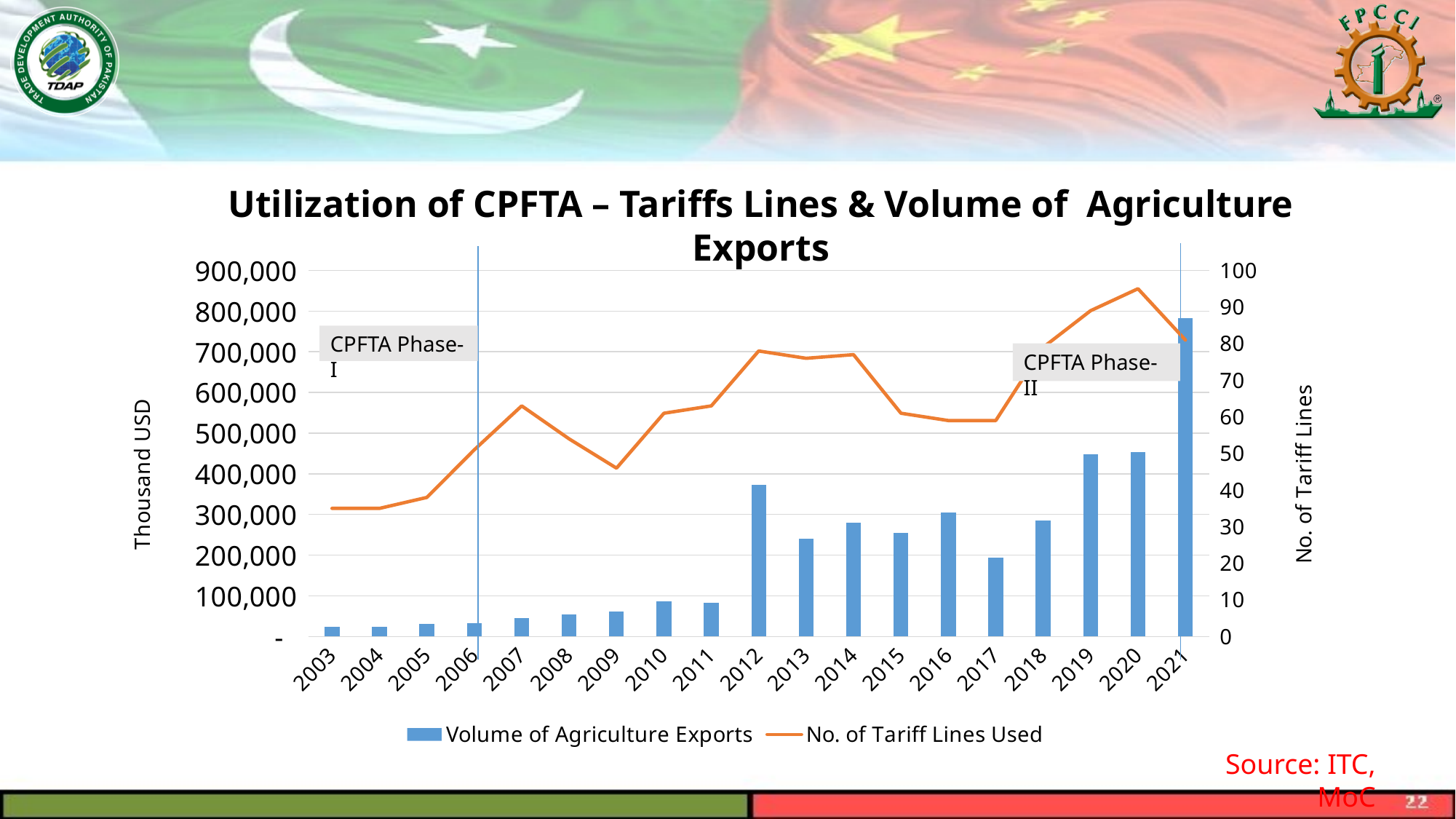
Which year has the highest Volume of Agriculture Exports? 2021 In which year does the No. of Tariff Lines Used line reach its peak? 2020 Is the Volume of Agriculture Exports for 2021 greater or less than 500,000? greater Is the Volume of Agriculture Exports for 2003 greater or less than 100,000? less What kind of chart is shown on the slide? A combined bar and line chart Is the No. of Tariff Lines Used in 2003 greater or less than 40? less What is the label on the left vertical axis? Thousand USD How many years are shown along the x axis? 19 Which year has the larger Volume of Agriculture Exports, 2017 or 2019? 2019 Overall, do the Volume of Agriculture Exports bars rise or fall from 2003 to 2021? rise How many series does the legend list? 2